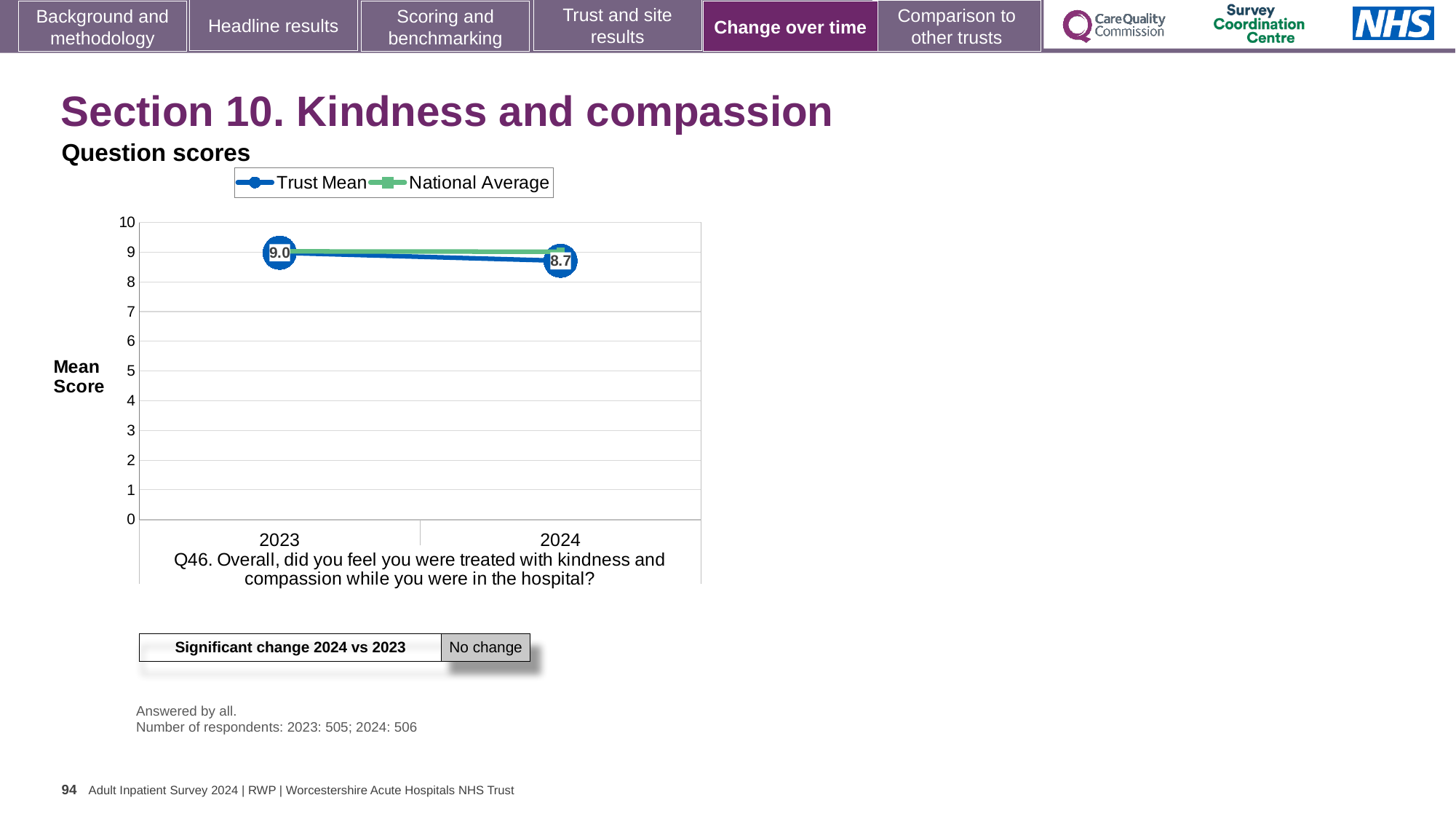
What is the Trust Mean score for 2024? 8.7 Does the Trust Mean score rise or fall from 2023 to 2024? fall How many series does the chart legend list? 2 What are the two series named in the chart legend? Trust Mean and National Average How many years are shown on the x axis of the chart? 2 What is the Trust Mean score for 2023? 9.0 In which year is the Trust Mean score lowest? 2024 What is the label on the y axis of the chart? Mean Score Is the National Average value for 2024 greater or less than 8? greater By how much did the Trust Mean score change from 2023 to 2024? 0.3 Which year has the higher Trust Mean score, 2023 or 2024? 2023 What kind of chart is shown on the slide? line chart